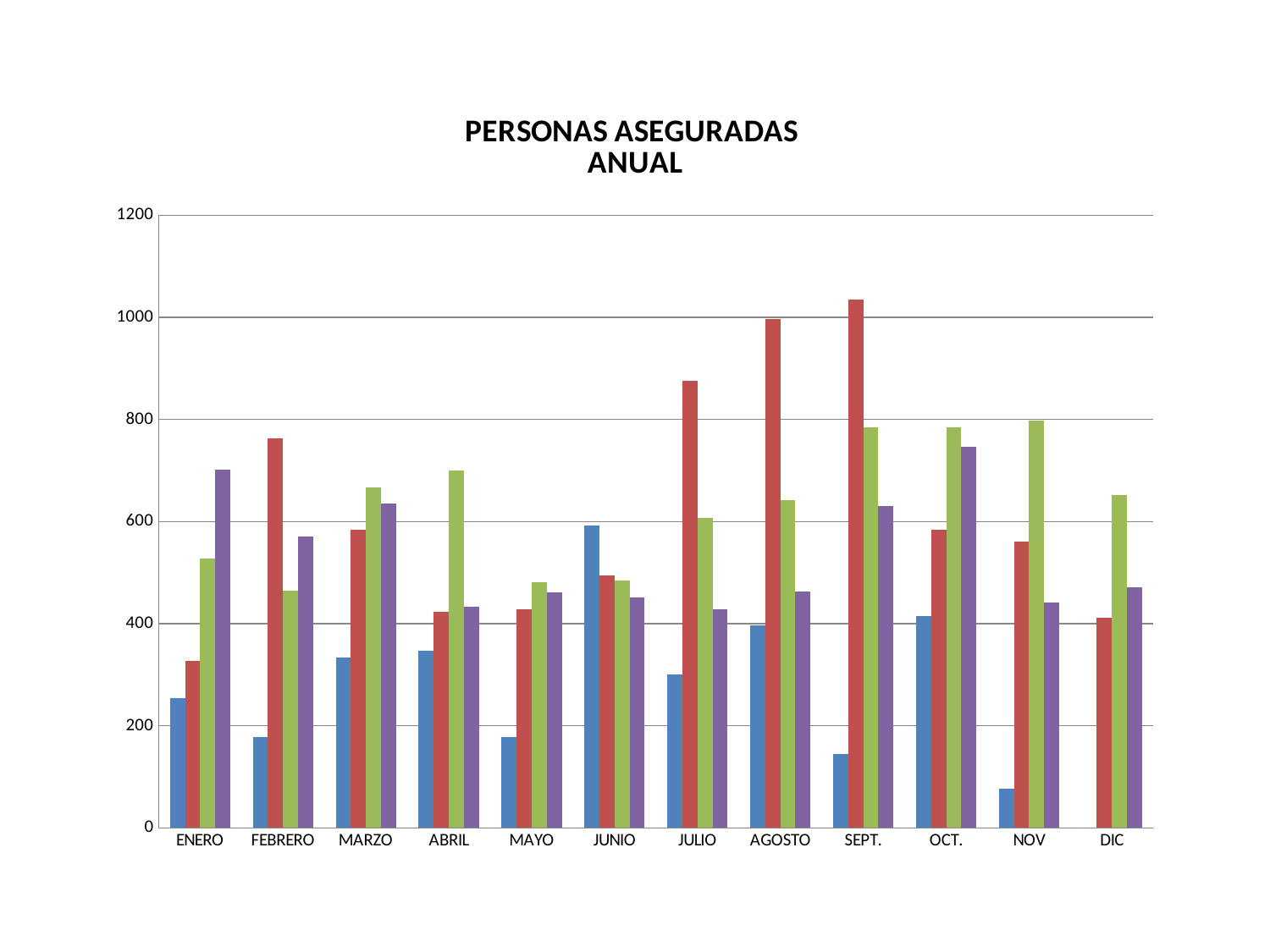
How many bar colours (series) are plotted for each month? 4 What is the title of the chart? PERSONAS ASEGURADAS ANUAL How many months (categories) are shown on the x axis? 12 What kind of chart is shown on the slide? bar chart Is the value of the blue bar for NOV greater or less than 200? less Is the value of the green bar for NOV greater or less than 600? greater Is the value of the red bar for SEPT. greater or less than 1000? greater In which month is the red bar the shortest? ENERO In which month is the blue bar the tallest? JUNIO In which month is the red bar the tallest? SEPT. For JUNIO, which is larger, the blue bar or the red bar? the blue bar